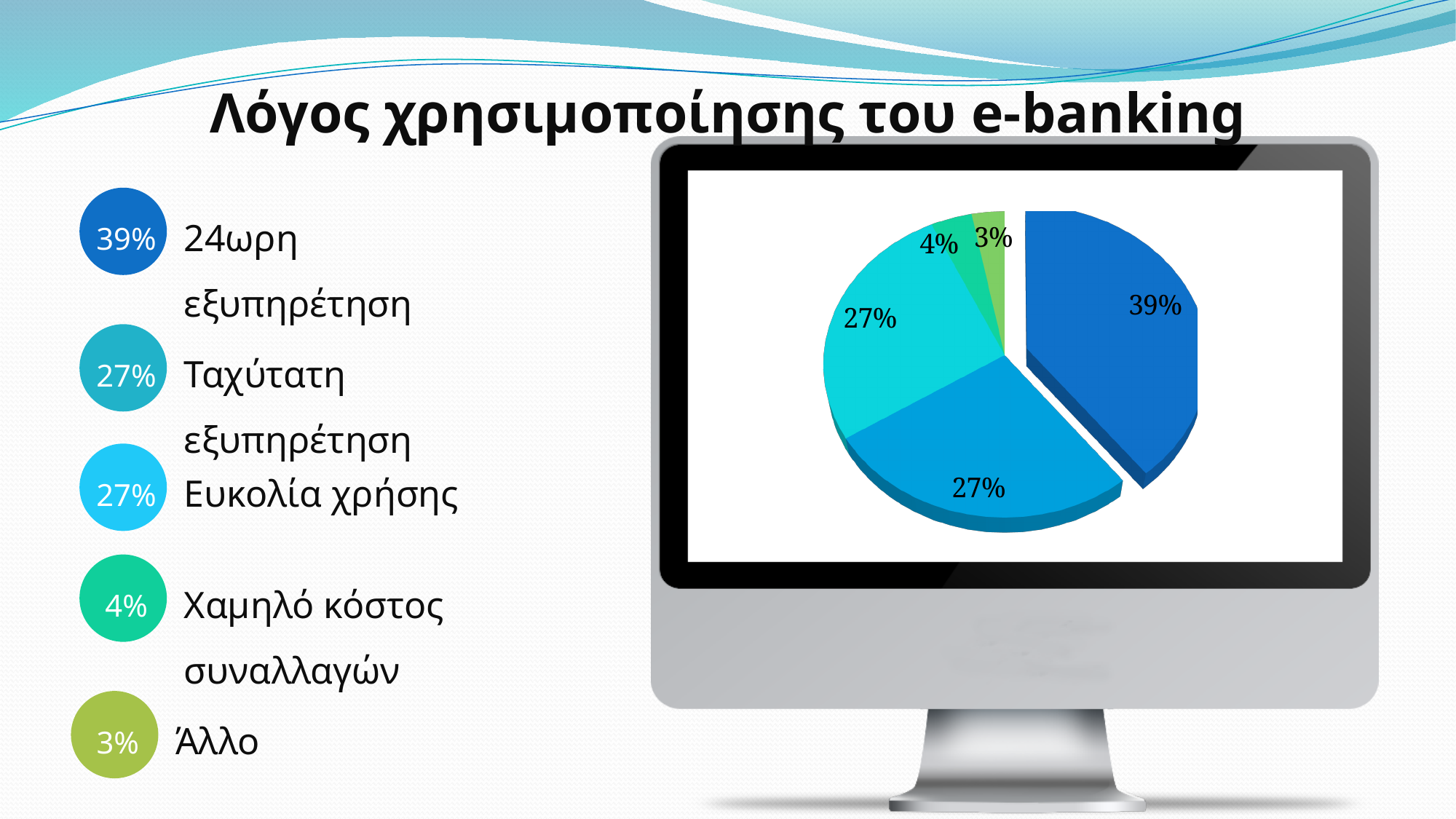
What share of the pie does 24ωρη εξυπηρέτηση take? 39% By how many percentage points does the 24ωρη εξυπηρέτηση slice exceed the Ταχύτατη εξυπηρέτηση slice? 12 percentage points What is the title of the slide containing the pie chart? Λόγος χρησιμοποίησης του e-banking Which is larger, the slice for 24ωρη εξυπηρέτηση or the slice for Ευκολία χρήσης? 24ωρη εξυπηρέτηση What do the slices for Ταχύτατη εξυπηρέτηση and Ευκολία χρήσης add up to? 54% Which category has the smallest slice of the pie chart? Άλλο What kind of chart is shown on the slide? Pie chart Which category has the largest slice of the pie chart? 24ωρη εξυπηρέτηση What is the value shown for Ευκολία χρήσης? 27% What is the value shown for Χαμηλό κόστος συναλλαγών? 4% What is the value shown for Άλλο? 3% How many slices does the pie chart have? 5